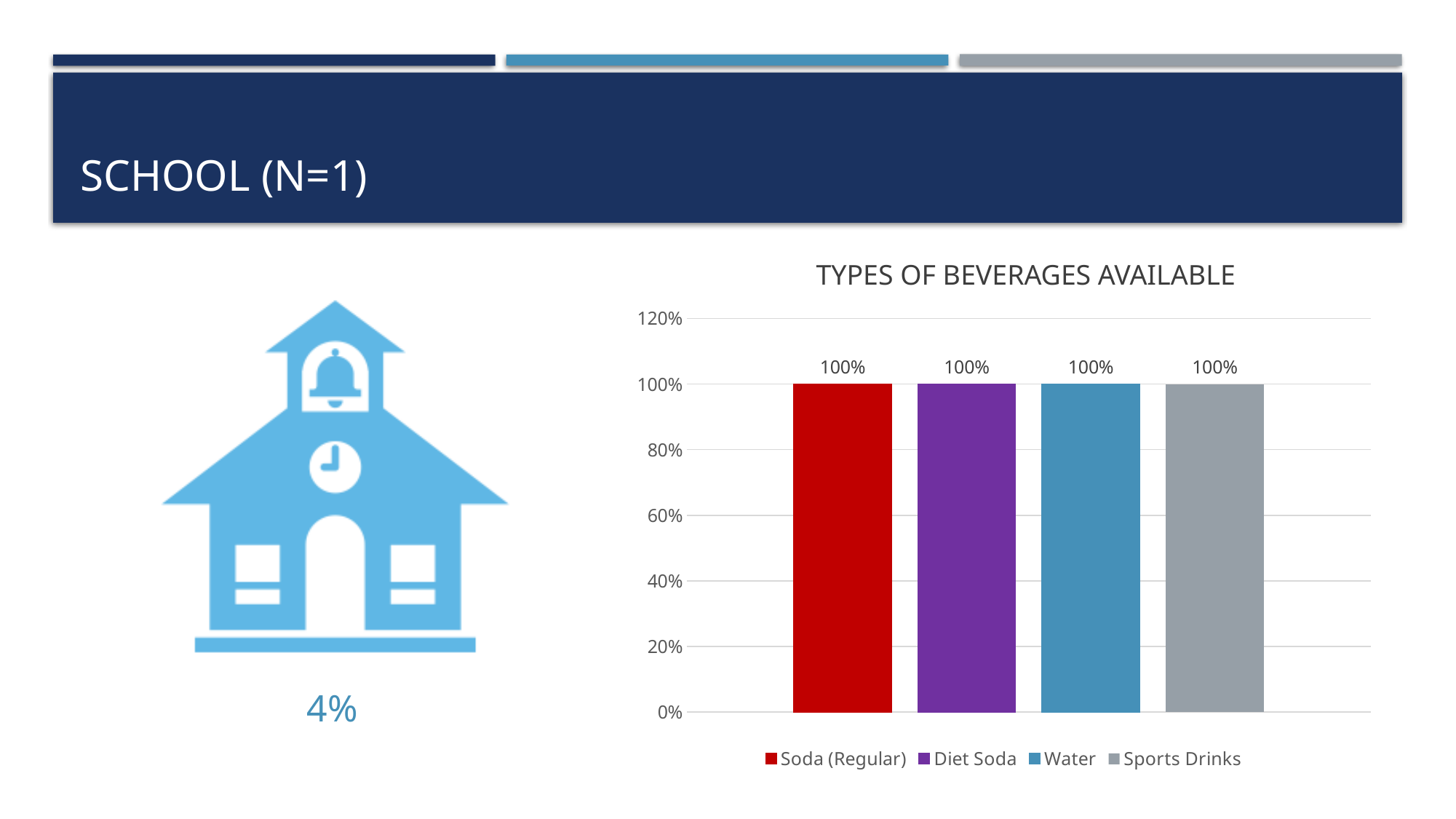
How many entries does the legend of the Types of Beverages Available chart list? 4 Is the value for Diet Soda in the Types of Beverages Available chart greater or less than 80%? greater What is the value for Water in the Types of Beverages Available chart? 100% What kind of chart is the Types of Beverages Available chart? Bar chart What colour is the Diet Soda bar in the Types of Beverages Available chart? Purple What is the title of the chart on the slide? Types of Beverages Available What is the value for Sports Drinks in the Types of Beverages Available chart? 100% How many bars are plotted in the Types of Beverages Available chart? 4 Is the value for Sports Drinks in the Types of Beverages Available chart greater or less than 120%? less What is the value for Soda (Regular) in the Types of Beverages Available chart? 100% What is the difference between the values for Water and Sports Drinks in the Types of Beverages Available chart? 0% What is the value for Diet Soda in the Types of Beverages Available chart? 100%